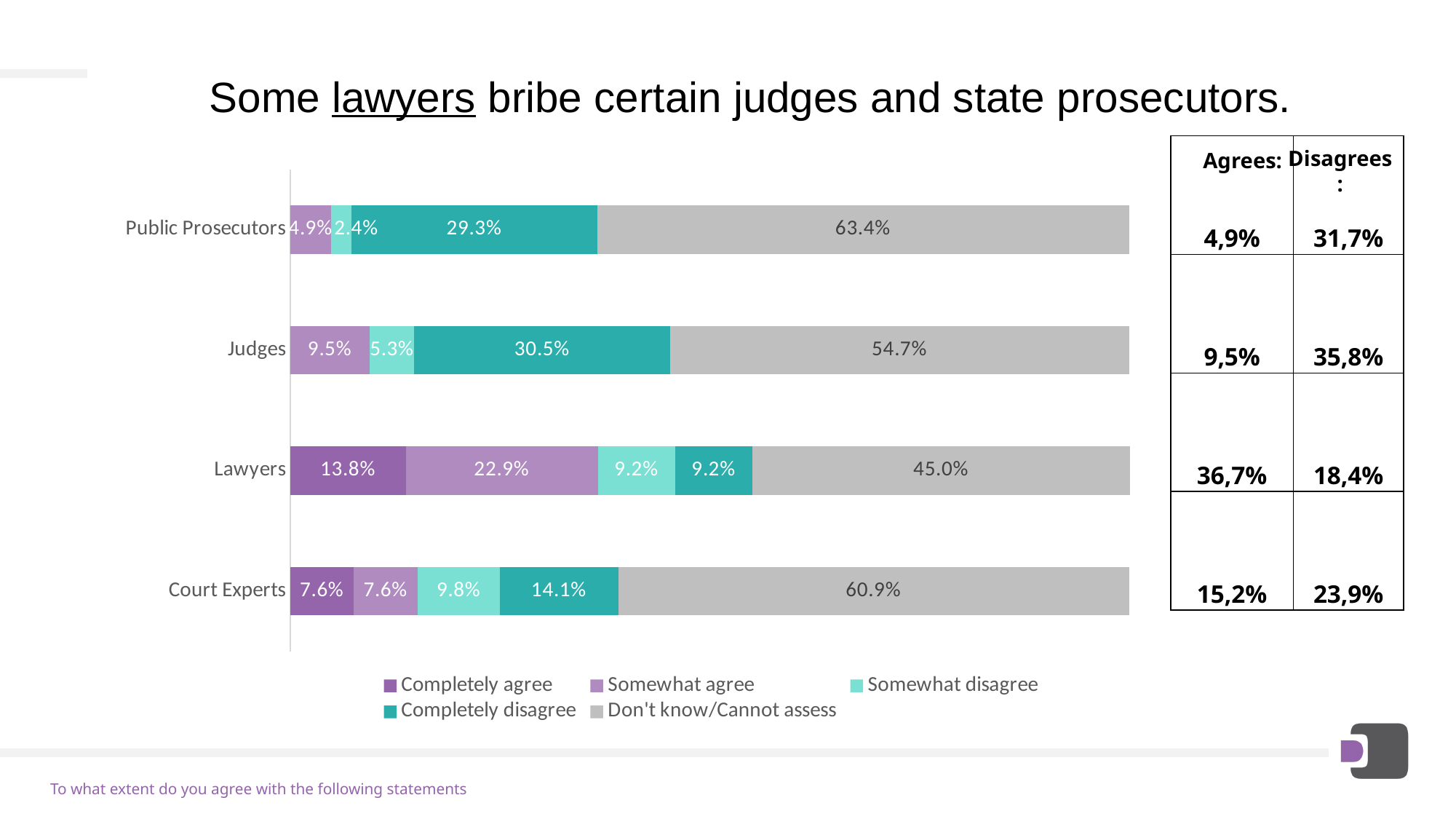
How many categories are plotted on the chart? 4 Which category has the highest 'Don't know/Cannot assess' value? Public Prosecutors What is the difference between the 'Somewhat agree' values for Lawyers and Judges? 13.4% What is the 'Somewhat disagree' value for Court Experts? 9.8% Which category has the lowest 'Don't know/Cannot assess' value? Lawyers What is the title of the chart? Some lawyers bribe certain judges and state prosecutors. What is the 'Don't know/Cannot assess' value for Public Prosecutors? 63.4% What is the 'Completely agree' value for Lawyers? 13.8% What type of chart is shown on the slide? Stacked bar chart How many series does the legend list? 5 What is the 'Completely disagree' value for Judges? 30.5% Which is larger, the 'Completely disagree' value for Court Experts or for Lawyers? Court Experts